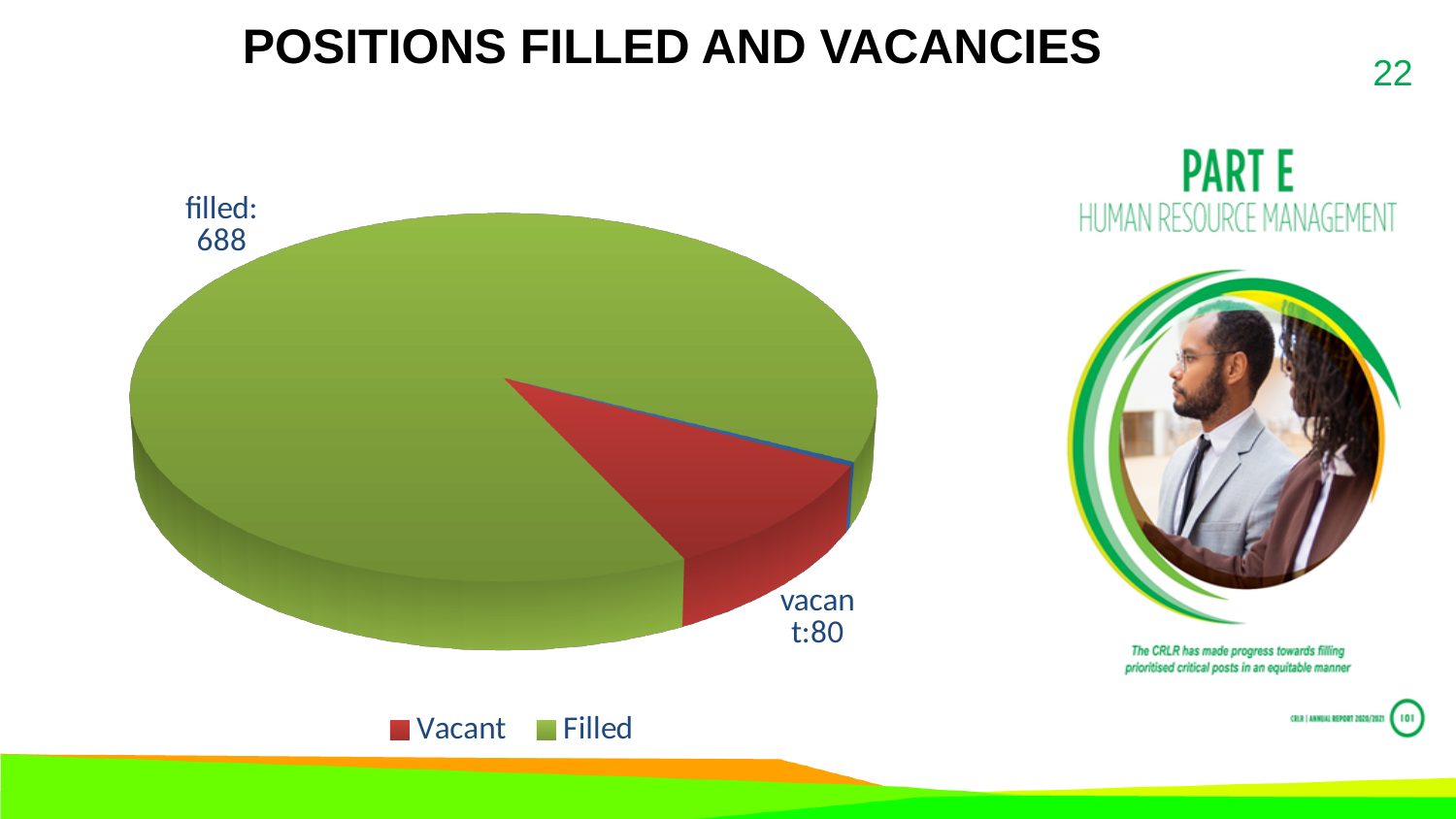
How many positions are vacant according to the chart? 80 How many positions are filled according to the chart? 688 How many slices does the pie chart have? 2 Which category has the largest slice of the pie? Filled How many entries does the legend list? 2 What colour represents the Vacant slice in the pie chart? red What kind of chart is shown on the slide? pie chart What is the title of the chart? POSITIONS FILLED AND VACANCIES What is the difference between the number of filled positions and the number of vacant positions? 608 What is the total number of positions represented in the pie chart? 768 Which category has the smallest slice of the pie? Vacant Which is larger, the number of filled positions or the number of vacant positions? Filled